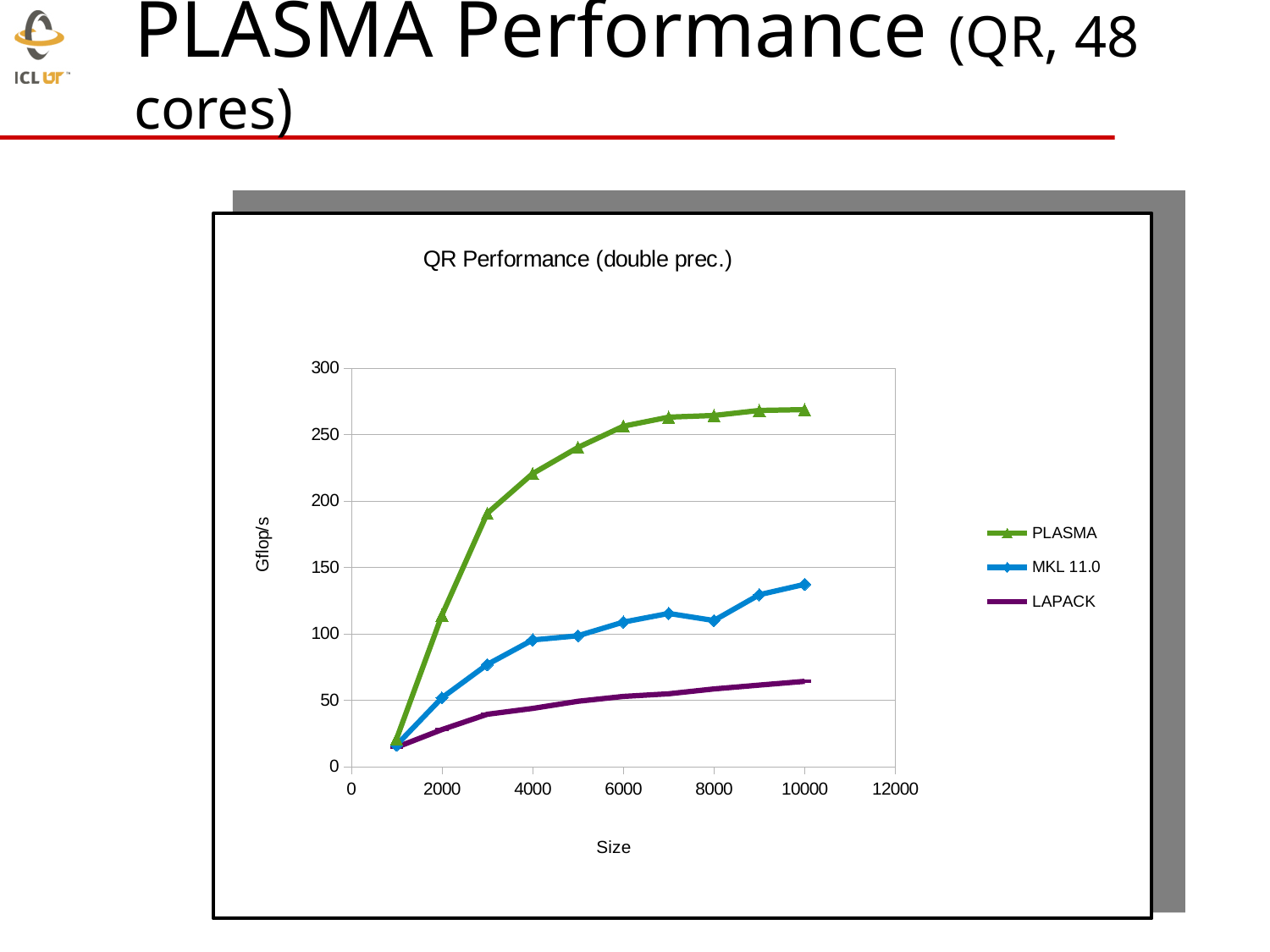
How many series does the legend list? 3 Which series has the highest value at size 10000? PLASMA Do the values for the PLASMA series rise or fall as size increases? rise What kind of chart is shown on the slide? line chart Is the value for PLASMA at size 10000 greater or less than 250? greater How many data points are plotted for the PLASMA series? 10 What is the title of the chart? QR Performance (double prec.) At size 6000, which is larger: the value for MKL 11.0 or the value for LAPACK? MKL 11.0 Is the value for MKL 11.0 at size 10000 greater or less than 150? less Is the value for LAPACK at size 4000 greater or less than 50? less Which series has the lowest value at size 10000? LAPACK What is the label of the y axis? Gflop/s